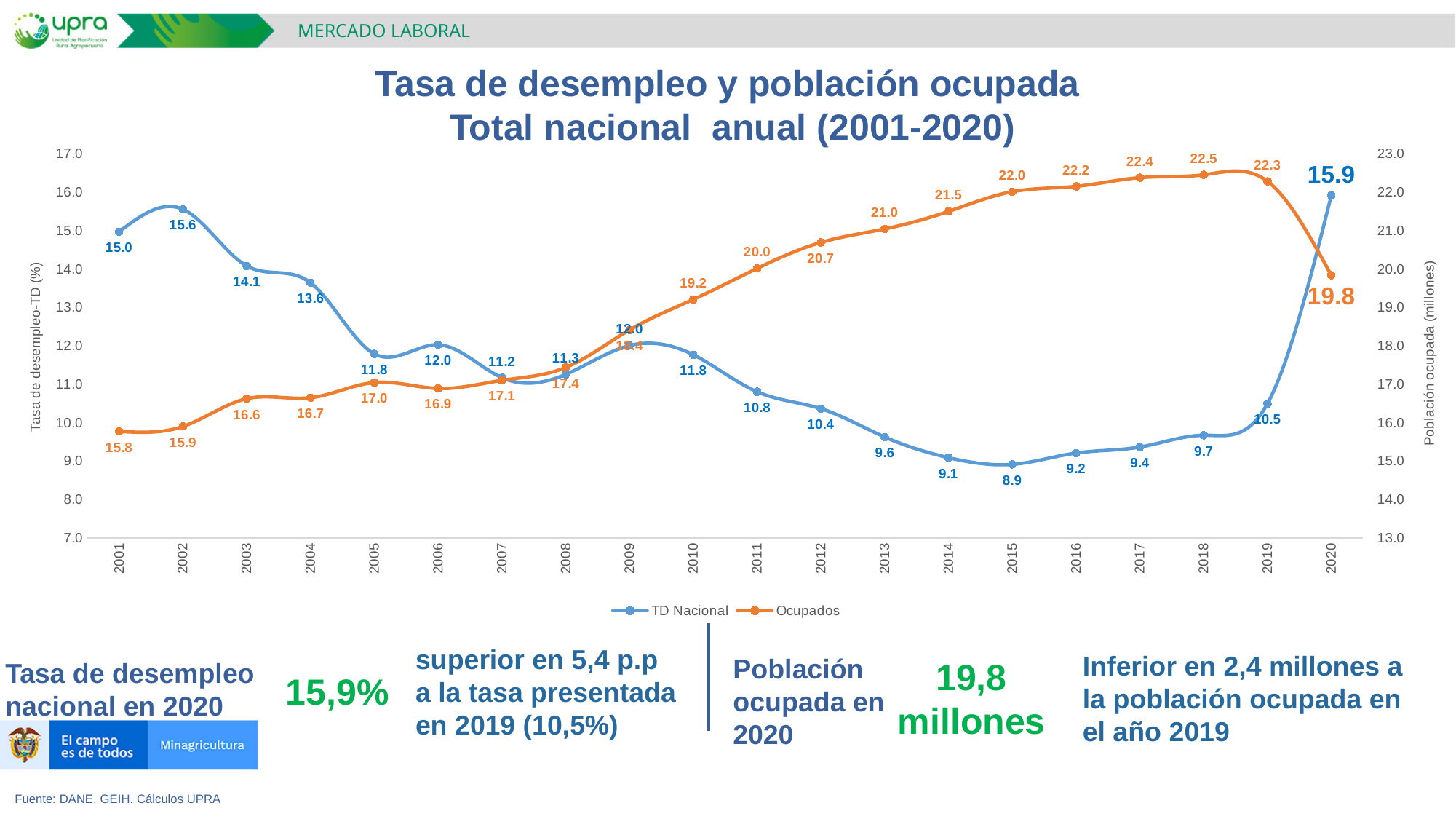
What is the difference between the TD Nacional values for 2020 and 2019? 5.4 What is the TD Nacional value for 2020? 15.9 What kind of chart is shown on the slide? Line chart Does the Ocupados series generally rise or fall from 2001 to 2018? Rise In which year is the TD Nacional series at its lowest? 2015 Which year has a higher Ocupados value, 2019 or 2020? 2019 How many series does the legend list? 2 In which year is the Ocupados series at its highest? 2018 What is the TD Nacional value for 2015? 8.9 What is the Ocupados value for 2012? 20.7 How many years are shown on the x axis? 20 What is the title of the chart? Tasa de desempleo y población ocupada Total nacional anual (2001-2020)